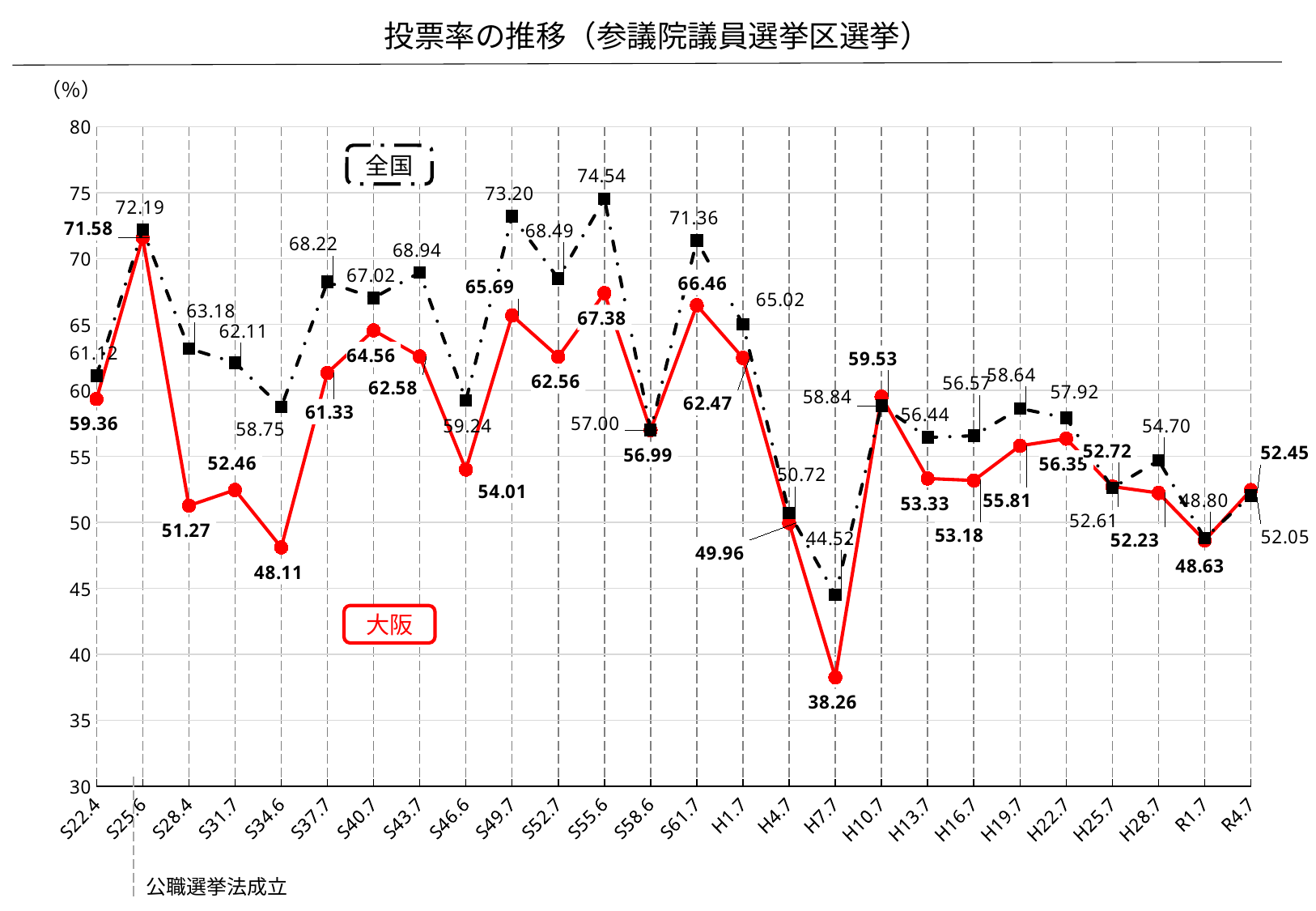
Is the 大阪 turnout rate at S34.6 greater or less than 50? less At R4.7, which series has the higher turnout rate, 全国 or 大阪? 大阪 What colour is the line for the 大阪 series? red At which election date is the 大阪 turnout rate lowest? H7.7 What kind of chart is shown on the slide? line chart What is the 大阪 turnout rate at H7.7? 38.26 What is the 全国 turnout rate at S55.6? 74.54 What is the difference between the 全国 and 大阪 turnout rates at H7.7? 6.26 What is the 大阪 turnout rate at R4.7? 52.45 At which election date is the 全国 turnout rate highest? S55.6 How many election dates are plotted along the x axis? 26 How many series does the chart show? 2